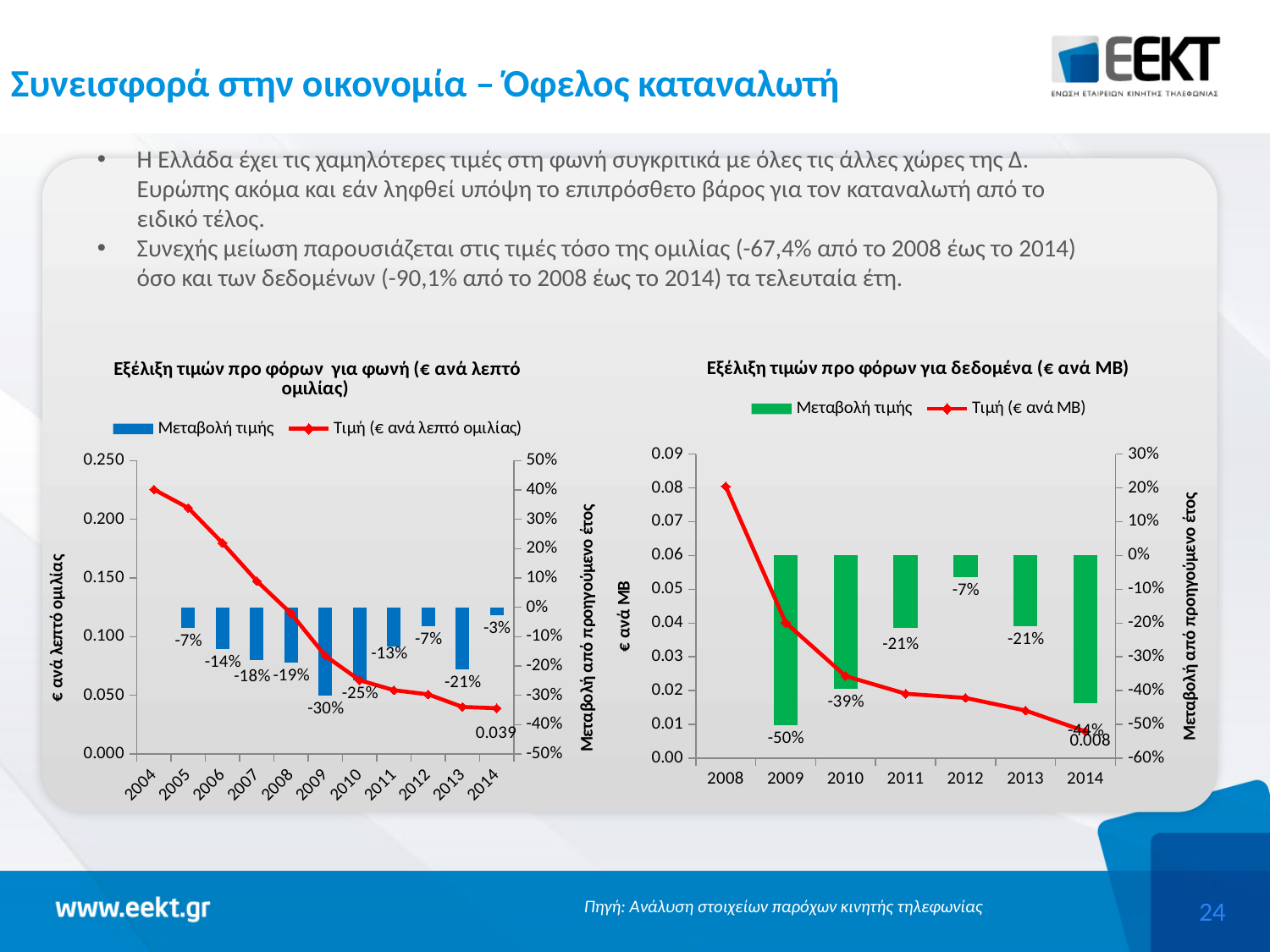
In the right chart (data prices), which year shows the largest percentage decrease in price? 2009 In the left chart (voice prices), which year shows the largest percentage decrease in price? 2009 In the left chart (voice prices), which year has the smaller price decrease, 2012 or 2014? 2014 In the left chart (voice prices), does the price line rise or fall from 2004 to 2014? Falls In the right chart (data prices), is the price per MB in 2008 greater or less than 0.07? greater In the left chart (voice prices), what is the price change (Μεταβολή τιμής) shown for 2009? -30% In the right chart (data prices), what is the difference in percentage points between the price change in 2009 and in 2010? 11 percentage points In the right chart (data prices), what price per MB is labelled for 2014? 0.008 In the right chart (data prices), what is the price change shown for 2010? -39% In the left chart (voice prices), how many years are shown on the x axis? 11 In the left chart (voice prices), what price per minute is labelled for 2014? 0.039 In the left chart (voice prices), how many series does the legend list? 2